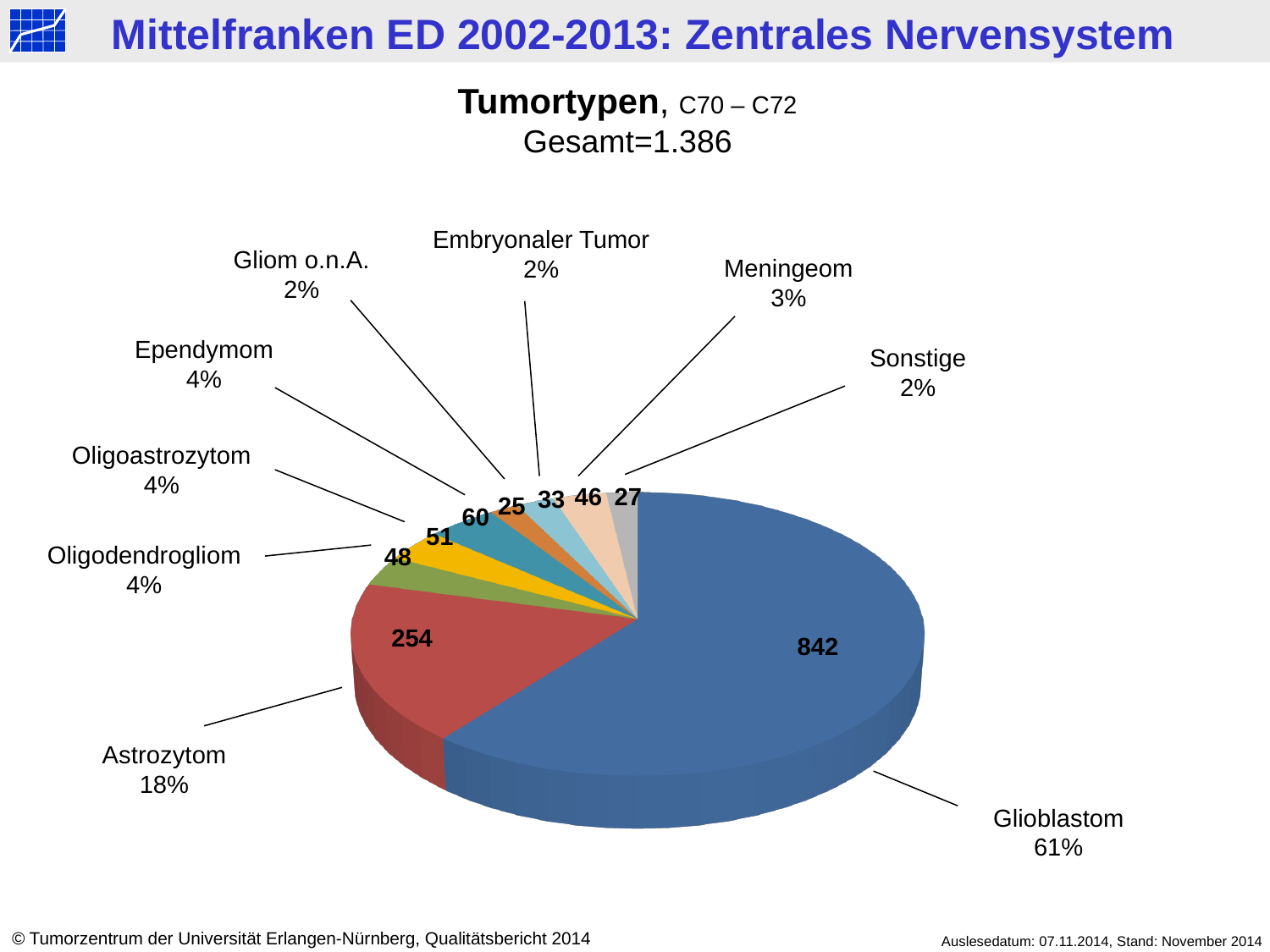
Which tumour type has the smallest number of cases in the pie chart? Gliom o.n.A. What percentage share does Meningeom have in the pie chart? 3% What type of chart is shown on the slide? pie chart What is the number of cases for Astrozytom? 254 How many tumour types (slices) does the pie chart show? 9 What ICD code range is given in the chart title next to 'Tumortypen'? C70 – C72 Which tumour type has the largest slice in the pie chart? Glioblastom Which has more cases, Ependymom or Meningeom? Ependymom What is the difference in cases between Glioblastom and Astrozytom? 588 What is the number of cases for Glioblastom? 842 What percentage share does Glioblastom have in the pie chart? 61% What is the total number of cases (Gesamt) given for the pie chart? 1.386